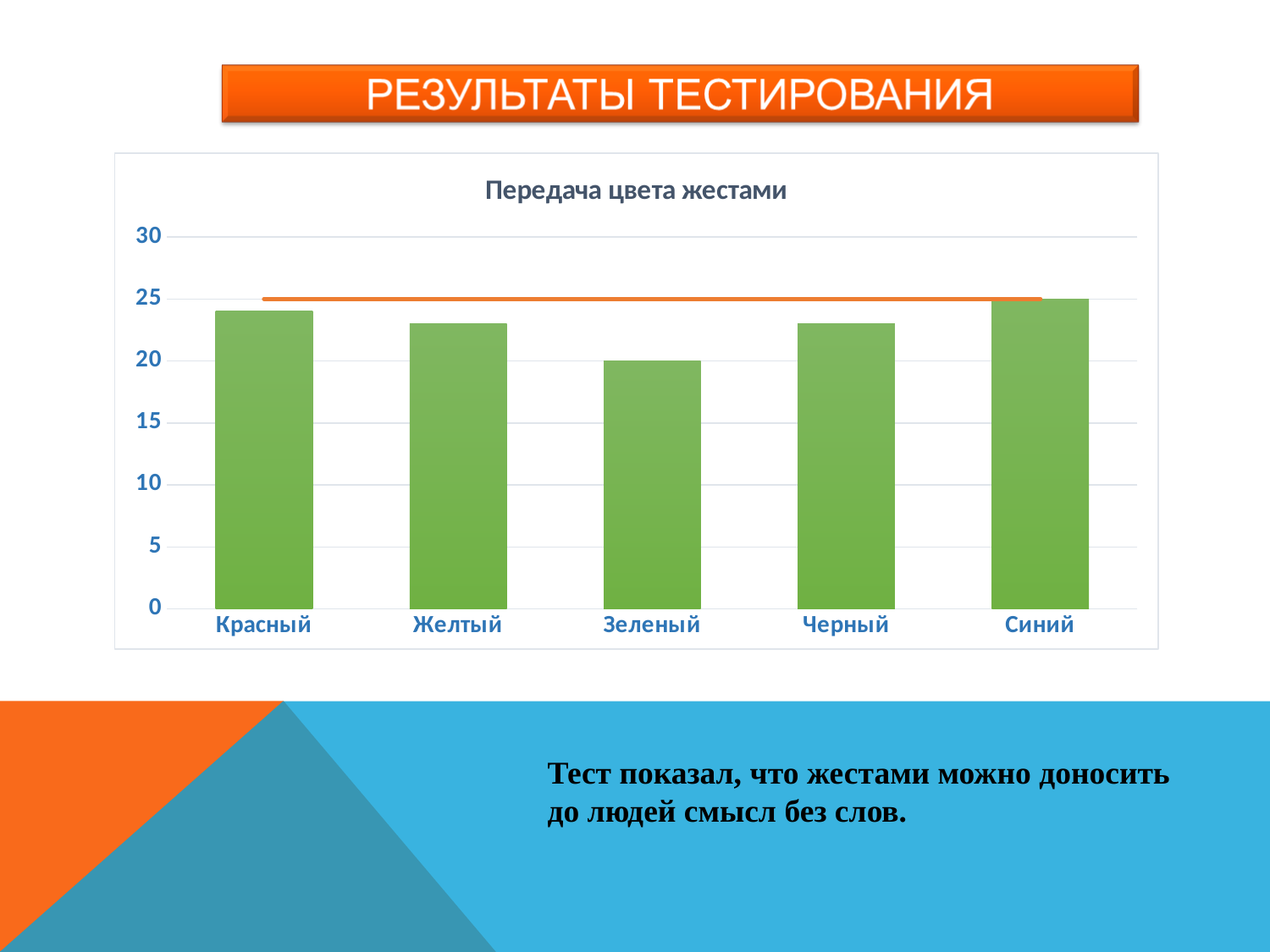
Is the value for Красный greater or less than 20? greater Which category has the lowest value? Зеленый What is the title of the chart? Передача цвета жестами How many categories are shown on the x axis of the chart? 5 Which category has the highest value? Синий What is the value for Зеленый? 20 What colour are the bars in the chart? green Is the value for Желтый greater or less than 25? less What kind of chart is shown on the slide? bar and line chart Which is larger, the value for Красный or the value for Зеленый? Красный What is the difference between the values for Синий and Зеленый? 5 What is the value for Синий? 25